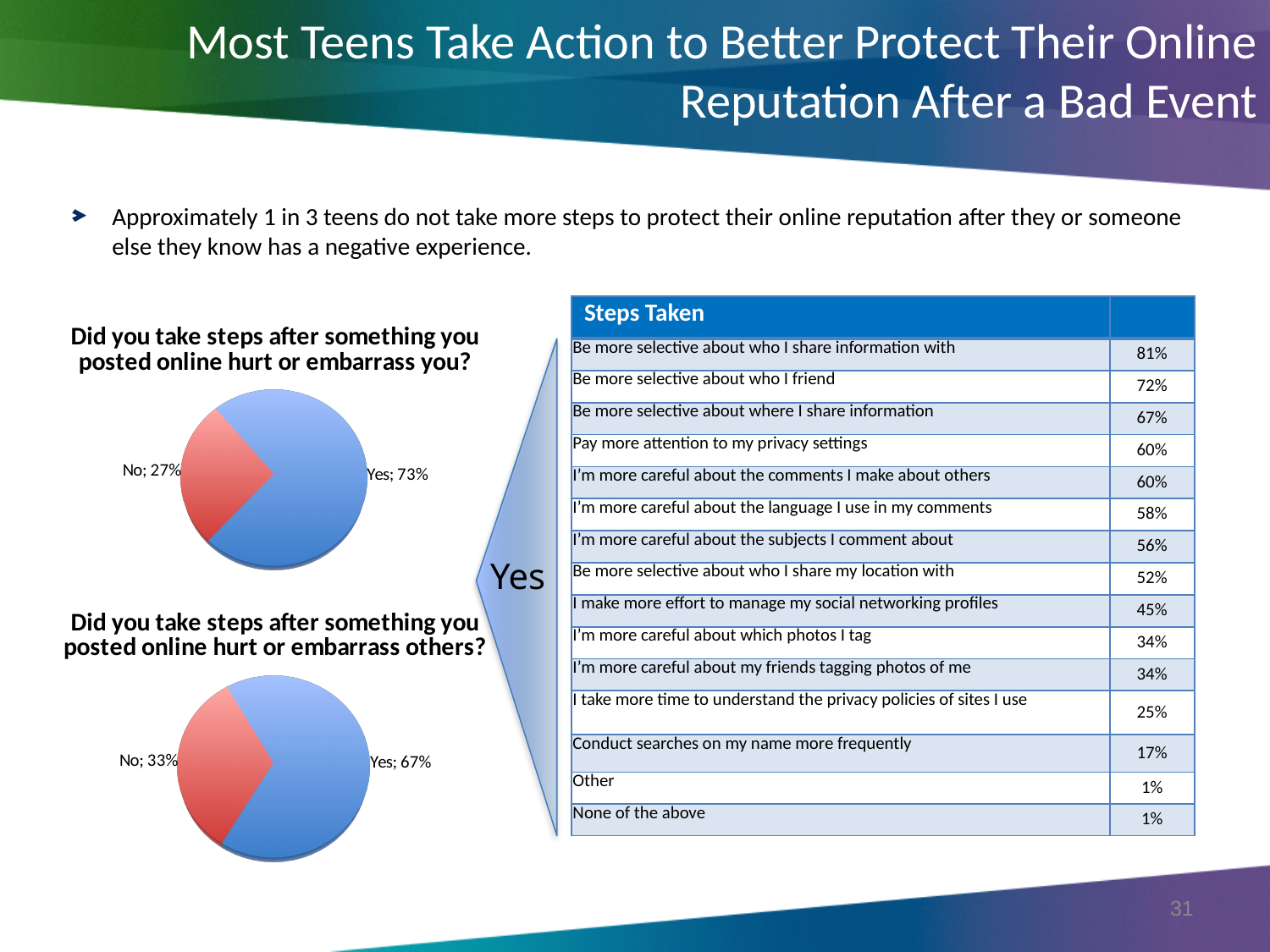
Is the "Yes" value larger in the upper pie chart (hurt or embarrass you) or in the lower pie chart (hurt or embarrass others)? Upper pie chart (73%) In the upper pie chart (about posts that hurt or embarrass you), what is the difference between the "Yes" and "No" values? 46% In the lower pie chart (about posts that hurt or embarrass others), what is the difference between the "Yes" and "No" values? 34% In the pie chart titled "Did you take steps after something you posted online hurt or embarrass you?", what is the value for "No"? 27% In the pie chart titled "Did you take steps after something you posted online hurt or embarrass others?", what is the value for "No"? 33% In the upper pie chart (about posts that hurt or embarrass you), what colour is the "No" slice? Red How many slices does the pie chart titled "Did you take steps after something you posted online hurt or embarrass you?" have? 2 In the pie chart titled "Did you take steps after something you posted online hurt or embarrass others?", what share of the pie is "Yes"? 67% In the upper pie chart (about posts that hurt or embarrass you), which slice is the largest? Yes What type of chart is used for "Did you take steps after something you posted online hurt or embarrass others?" Pie chart In the lower pie chart (about posts that hurt or embarrass others), which slice is the smallest? No In the pie chart titled "Did you take steps after something you posted online hurt or embarrass you?", what share of the pie is "Yes"? 73%